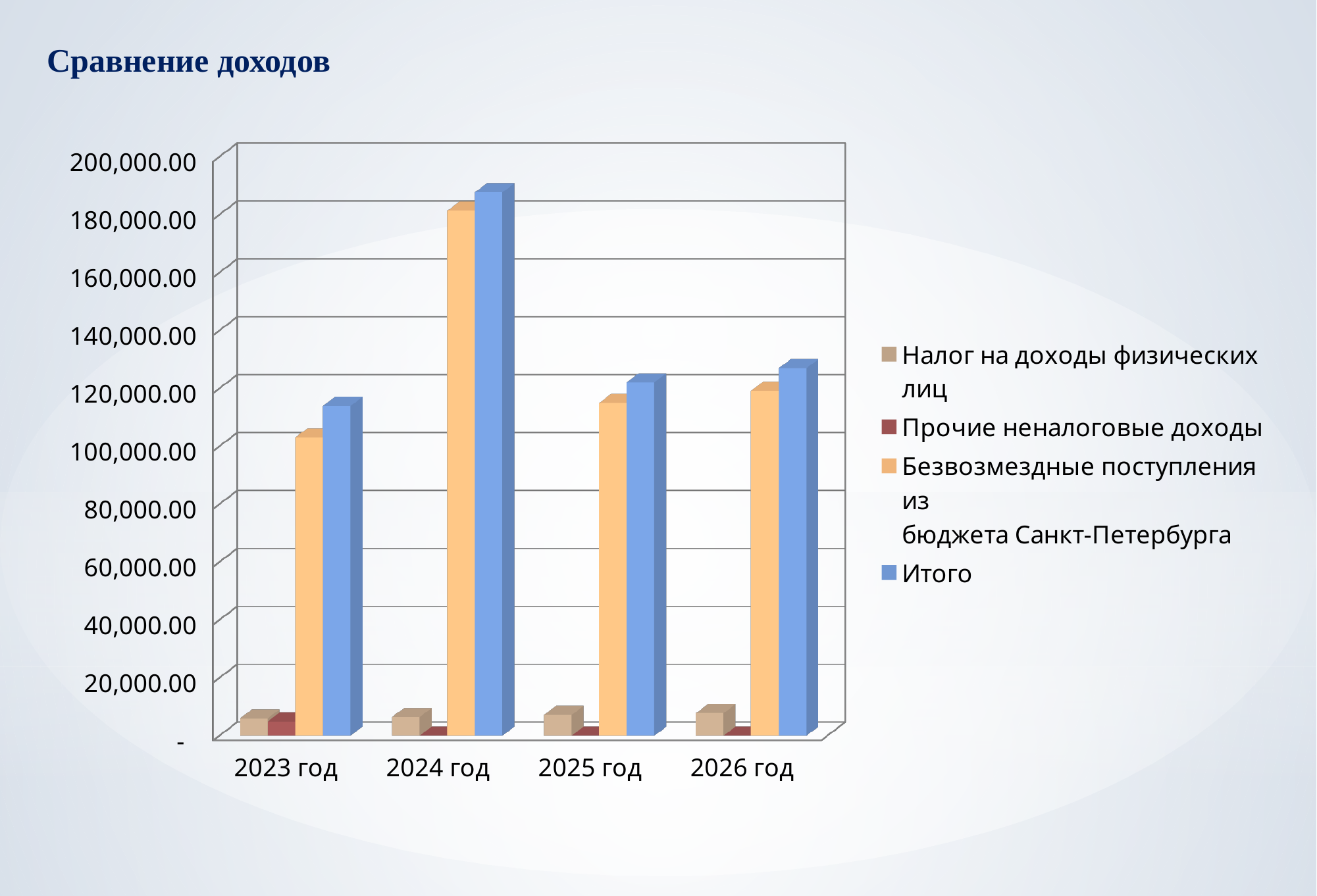
In which year is the value for Итого the lowest? 2023 год Is the value for Налог на доходы физических лиц in 2026 год greater or less than 20,000.00? less Is the value for Итого in 2025 год greater or less than 140,000.00? less How many year categories are shown on the x axis? 4 Is the value for Итого in 2023 год greater or less than 100,000.00? greater In which year is the value for Итого the highest? 2024 год Which series has the smallest values in every year? Прочие неналоговые доходы Which is larger, the value for Итого in 2023 год or in 2026 год? 2026 год How many series does the legend list? 4 What is the title of the chart? Сравнение доходов What kind of chart is shown on the slide? bar chart